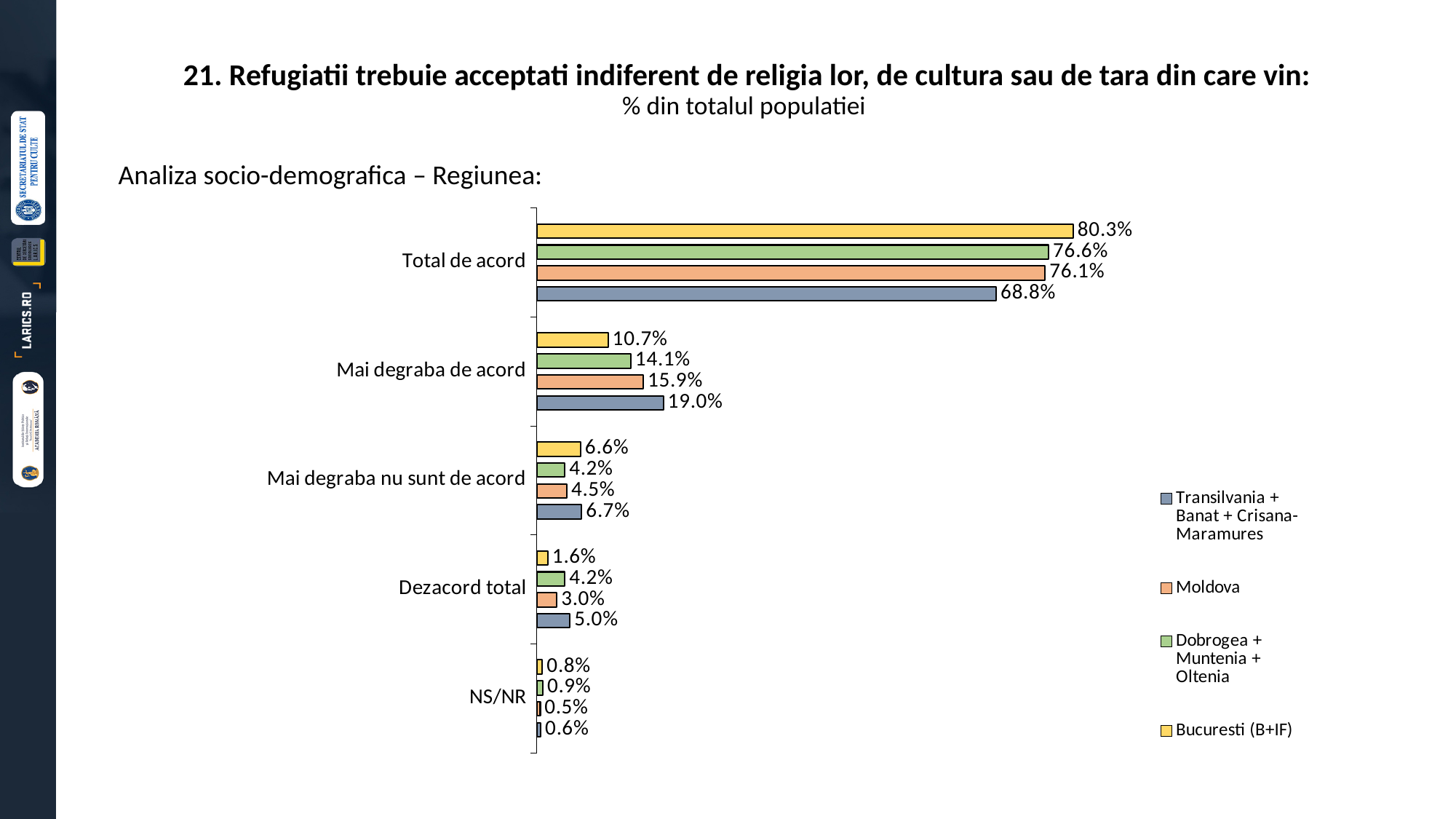
How many series does the legend list? 4 What is the difference between the Bucuresti (B+IF) and Transilvania + Banat + Crisana-Maramures values in the 'Total de acord' category? 11.5% What is the value for Transilvania + Banat + Crisana-Maramures in the 'Mai degraba de acord' category? 19.0% Which region has the highest value in the 'Total de acord' category? Bucuresti (B+IF) Which region has the lowest value in the 'Mai degraba de acord' category? Bucuresti (B+IF) What is the value for Bucuresti (B+IF) in the 'Total de acord' category? 80.3% What kind of chart is shown on the slide? Bar chart How many response categories are shown on the chart? 5 In the 'Dezacord total' category, which is larger: the value for Transilvania + Banat + Crisana-Maramures or the value for Bucuresti (B+IF)? Transilvania + Banat + Crisana-Maramures What is the value for Dobrogea + Muntenia + Oltenia in the 'NS/NR' category? 0.9% What is the value for Moldova in the 'Dezacord total' category? 3.0% What is the subtitle printed under the chart title? % din totalul populatiei